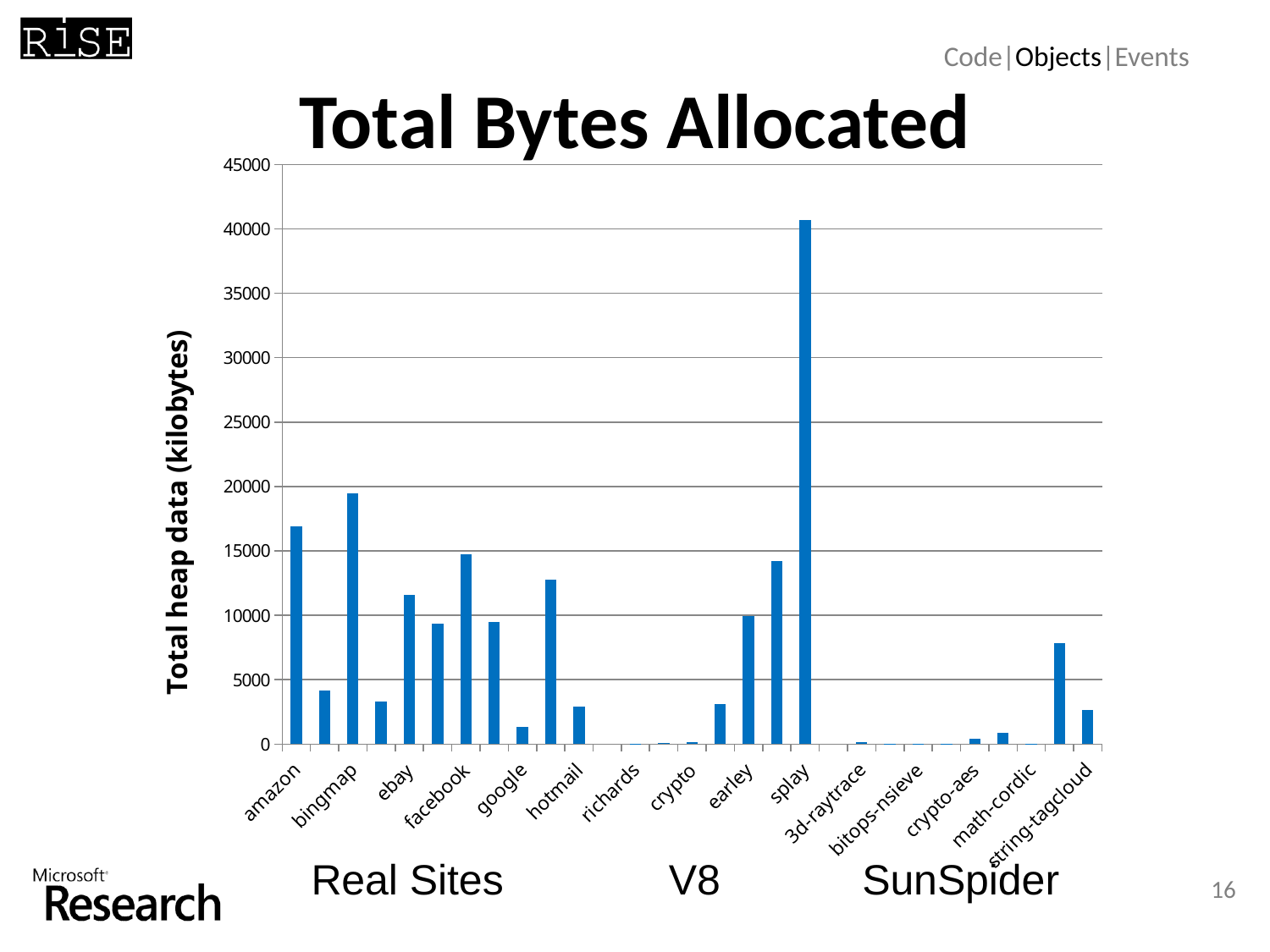
Which category has the highest total bytes allocated? splay Is the value for google greater or less than 5000? less Is the value for string-tagcloud greater or less than 5000? less Is the value for amazon greater or less than 15000? greater What is the label on the vertical axis? Total heap data (kilobytes) What kind of chart is shown on the slide? bar chart Which has a larger value, bingmap or ebay? bingmap Which has a larger value, splay or earley? splay What is the title of the chart? Total Bytes Allocated Which has a larger value, facebook or hotmail? facebook